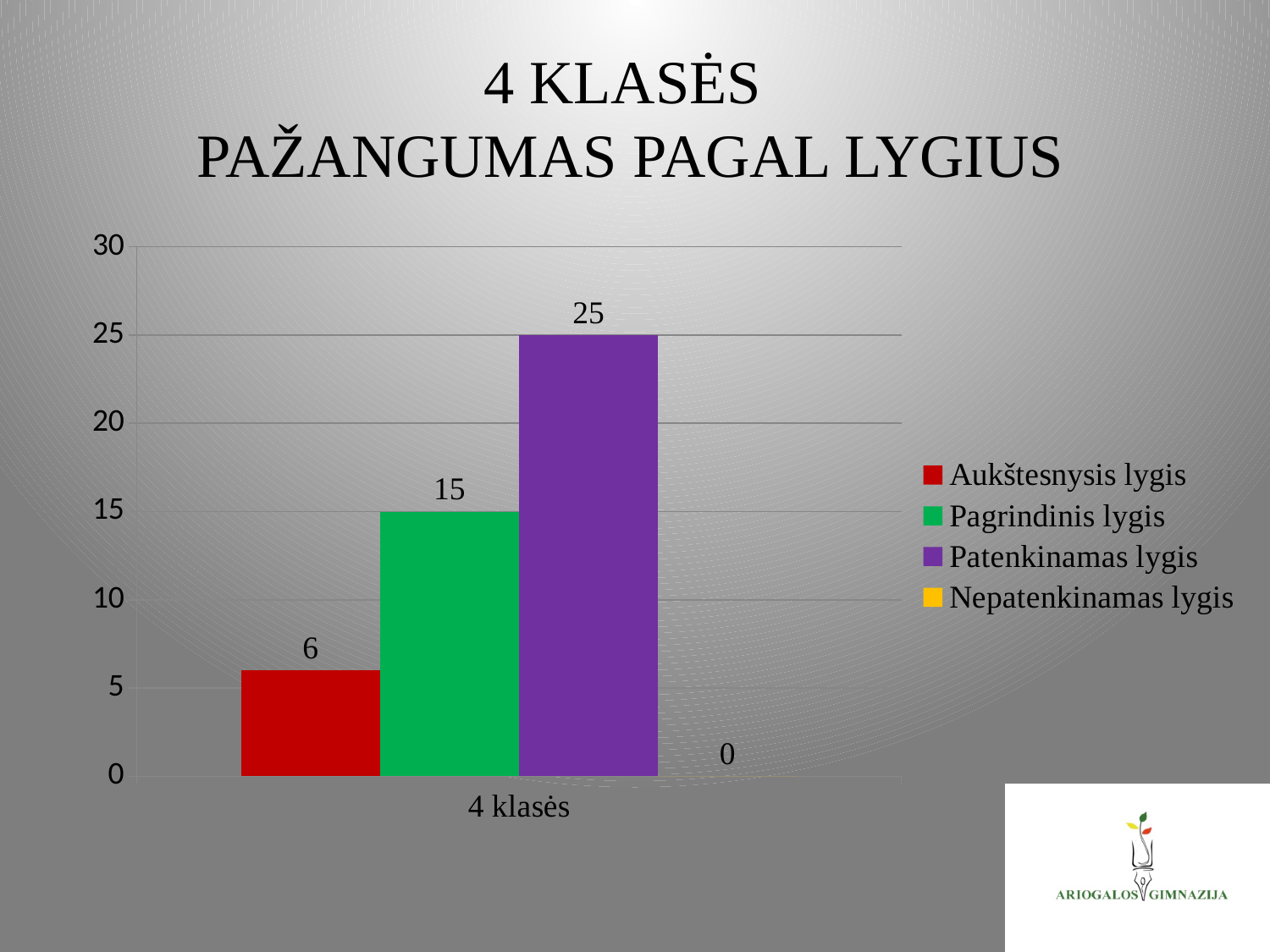
Is the value for Patenkinamas lygis greater or less than 20? greater What is the value for Nepatenkinamas lygis? 0 Which is larger, the value for Pagrindinis lygis or the value for Aukštesnysis lygis? Pagrindinis lygis What is the value for Patenkinamas lygis? 25 What kind of chart is shown on the slide? bar chart Which series has the lowest value? Nepatenkinamas lygis What is the value for Aukštesnysis lygis? 6 What is the difference between the values for Patenkinamas lygis and Pagrindinis lygis? 10 How many series does the legend list? 4 What is the value for Pagrindinis lygis? 15 Which series has the highest value? Patenkinamas lygis What colour is the bar for Patenkinamas lygis? purple